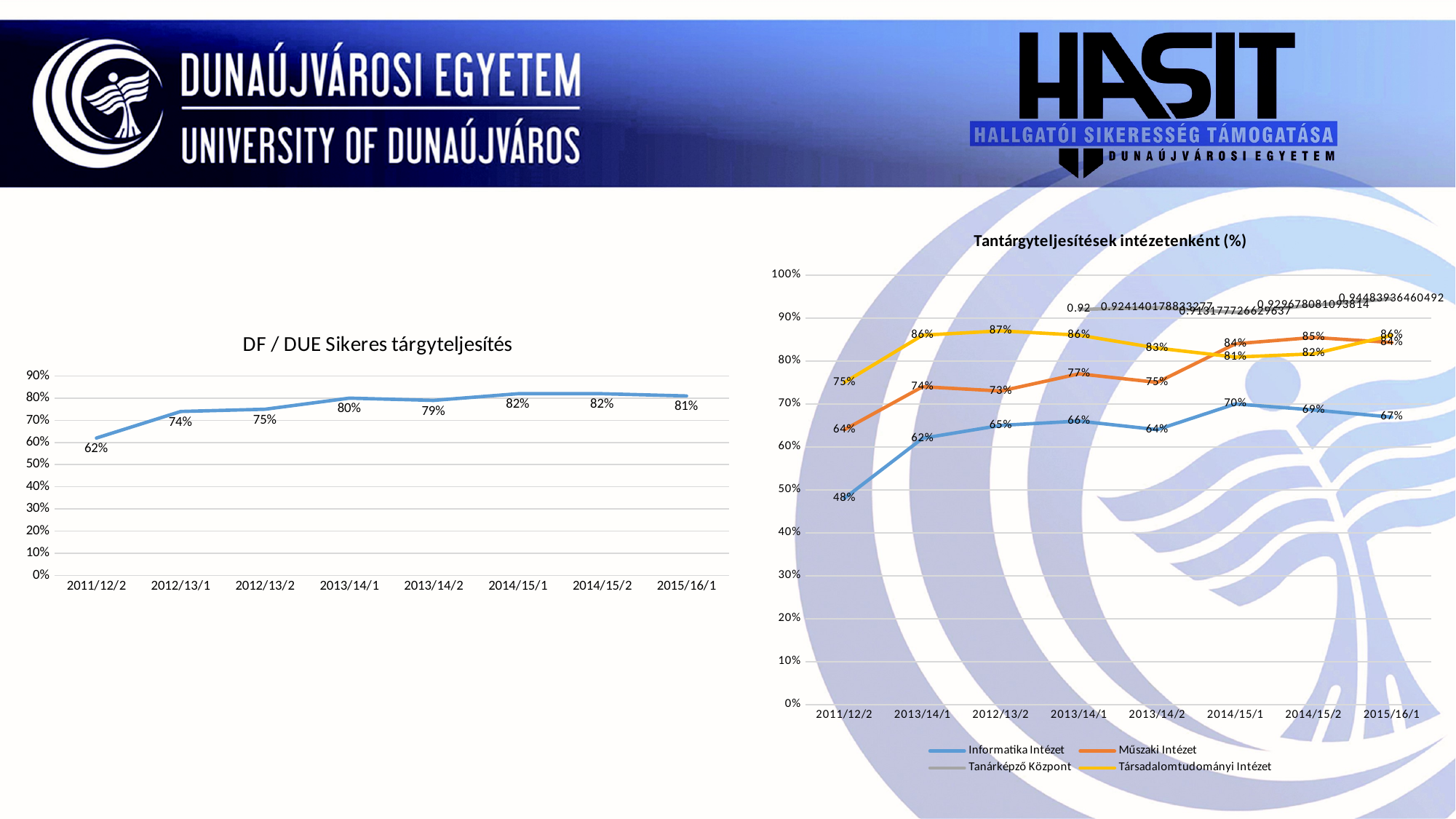
In the chart titled "DF / DUE Sikeres tárgyteljesítés", what is the value for 2015/16/1? 81% In the chart titled "DF / DUE Sikeres tárgyteljesítés", what is the value for 2011/12/2? 62% In the chart titled "Tantárgyteljesítések intézetenként (%)", which series is shown in orange? Műszaki Intézet In the chart titled "Tantárgyteljesítések intézetenként (%)", what is the value for Műszaki Intézet in 2014/15/2? 85% In the chart titled "Tantárgyteljesítések intézetenként (%)", what is the difference between Műszaki Intézet and Informatika Intézet in 2011/12/2? 16% In the chart titled "Tantárgyteljesítések intézetenként (%)", how many series does the legend list? 4 In the chart titled "DF / DUE Sikeres tárgyteljesítés", which period has the lowest value? 2011/12/2 In the chart titled "Tantárgyteljesítések intézetenként (%)", which is larger in 2015/16/1: Informatika Intézet or Társadalomtudományi Intézet? Társadalomtudományi Intézet In the chart titled "DF / DUE Sikeres tárgyteljesítés", how many data points are plotted? 8 In the chart titled "Tantárgyteljesítések intézetenként (%)", what is the value for Informatika Intézet in 2011/12/2? 48% In the chart titled "DF / DUE Sikeres tárgyteljesítés", what is the difference between the values for 2014/15/1 and 2011/12/2? 20% What kind of chart is the chart titled "DF / DUE Sikeres tárgyteljesítés"? Line chart